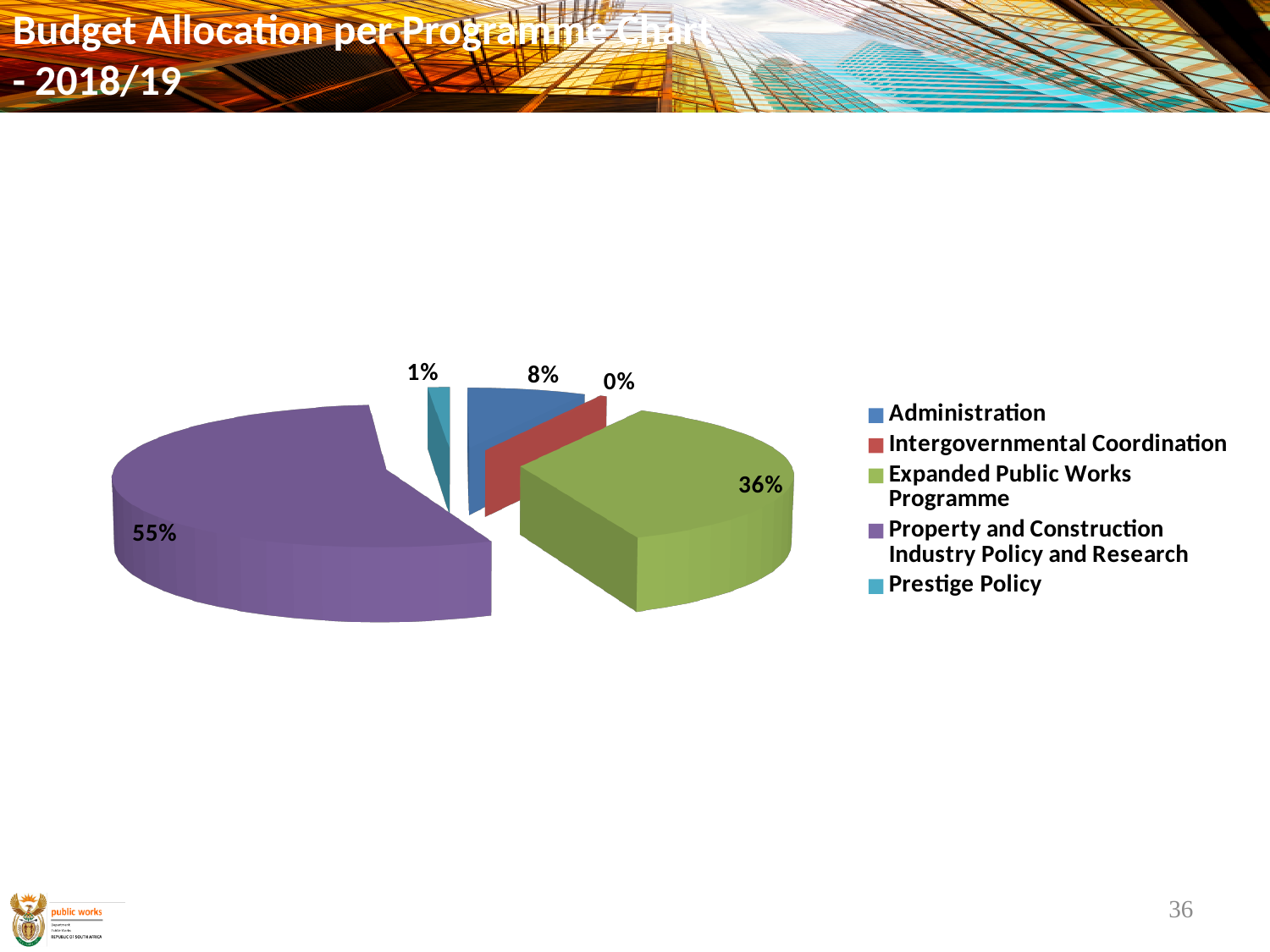
What share of the budget is allocated to the Expanded Public Works Programme? 36% Which programme receives the smallest share of the budget? Intergovernmental Coordination What kind of chart is shown on the slide? pie chart How many programmes are listed in the legend? 5 Which has a larger share of the budget, Administration or Prestige Policy? Administration Which programme receives the largest share of the budget? Property and Construction Industry Policy and Research What share of the budget is allocated to Property and Construction Industry Policy and Research? 55% What colour is the slice for the Expanded Public Works Programme? green What share of the budget is allocated to Prestige Policy? 1% What is the difference in percentage points between the shares for Property and Construction Industry Policy and Research and the Expanded Public Works Programme? 19 What share of the budget is allocated to Administration? 8% What share of the budget is allocated to Intergovernmental Coordination? 0%